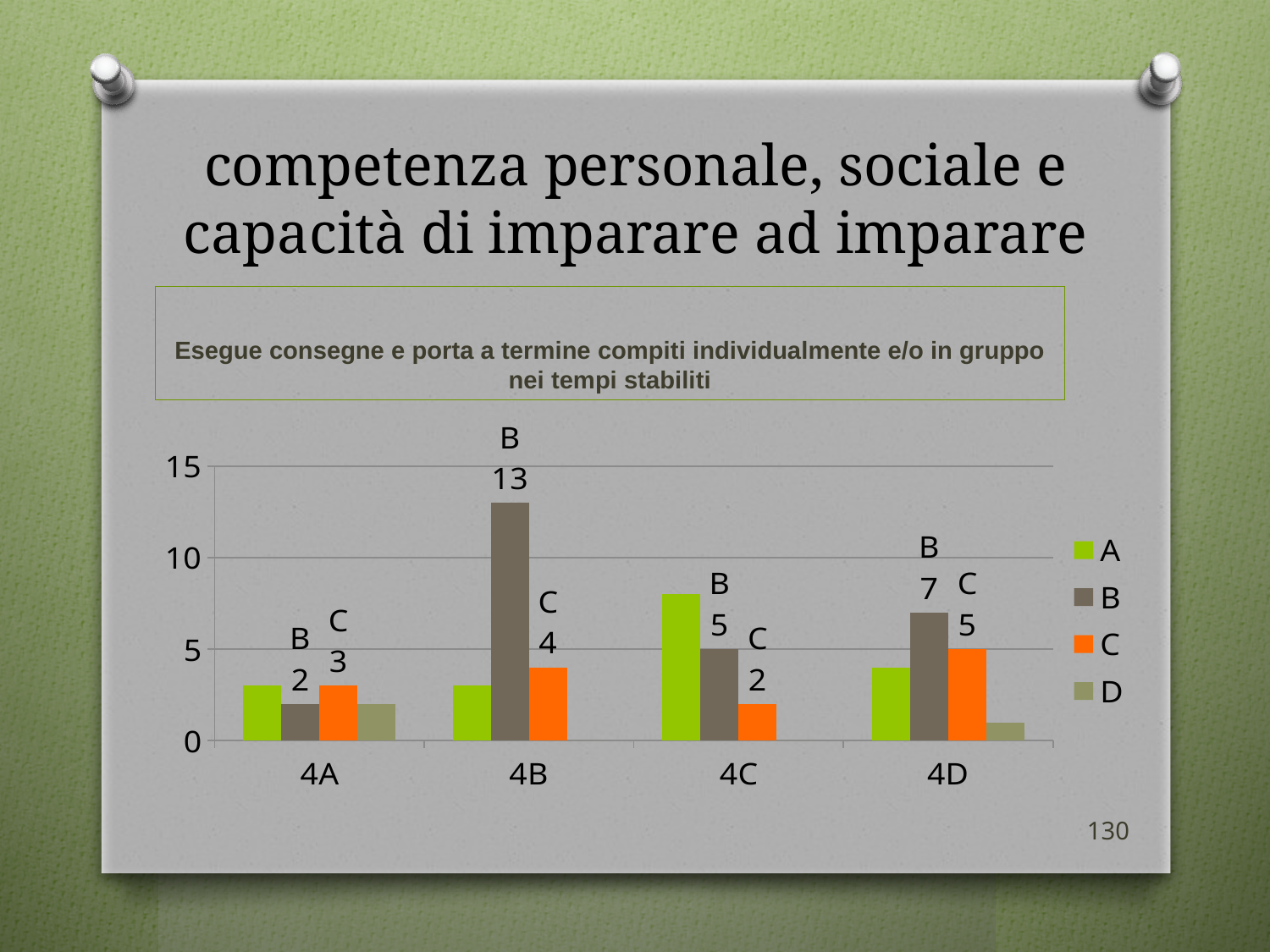
Which category has the lowest value for series B? 4A What is the value of series B for category 4B? 13 What kind of chart is shown on the slide? bar chart Which category has the highest value for series B? 4B Is the value of series A for category 4C greater or less than 5? greater How many categories are shown on the x axis? 4 What is the difference between the series B values for 4B and 4A? 11 What is the value of series C for category 4D? 5 What is the value of series B for category 4A? 2 Which is larger: series C for 4B or series C for 4D? series C for 4D What is the value of series C for category 4C? 2 How many series does the legend list? 4